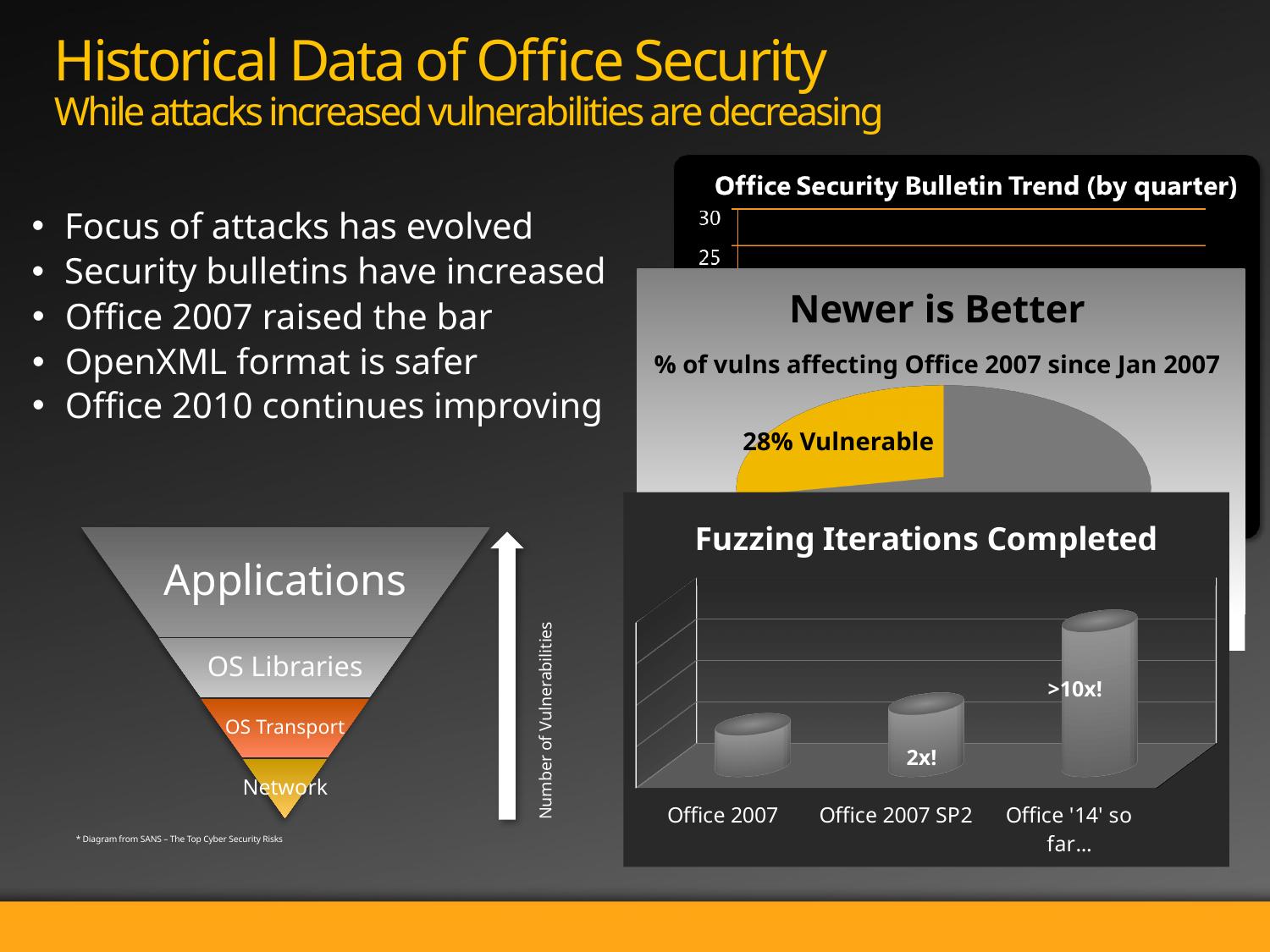
In the 'Fuzzing Iterations Completed' chart, do the bars rise or fall from left to right? rise In the 'Fuzzing Iterations Completed' chart, which bar is taller: Office 2007 or Office 2007 SP2? Office 2007 SP2 In the 'Fuzzing Iterations Completed' chart, what label is printed on the Office 2007 SP2 bar? 2x! In the 'Fuzzing Iterations Completed' chart, which category has the highest bar? Office '14' so far... In the 'Newer is Better' pie chart, what share is labelled as vulnerable? 28% What colour is the 'Vulnerable' slice in the 'Newer is Better' pie chart? yellow In the 'Fuzzing Iterations Completed' chart, which category has the lowest bar? Office 2007 What is the title of the chart in the top right of the slide, partly hidden behind the other charts? Office Security Bulletin Trend (by quarter) In the 'Fuzzing Iterations Completed' chart, what label is printed on the Office '14' so far... bar? >10x! What kind of chart is shown under the 'Newer is Better' heading? pie chart How many categories are shown on the x axis of the 'Fuzzing Iterations Completed' chart? 3 What kind of chart is the 'Fuzzing Iterations Completed' chart? bar chart